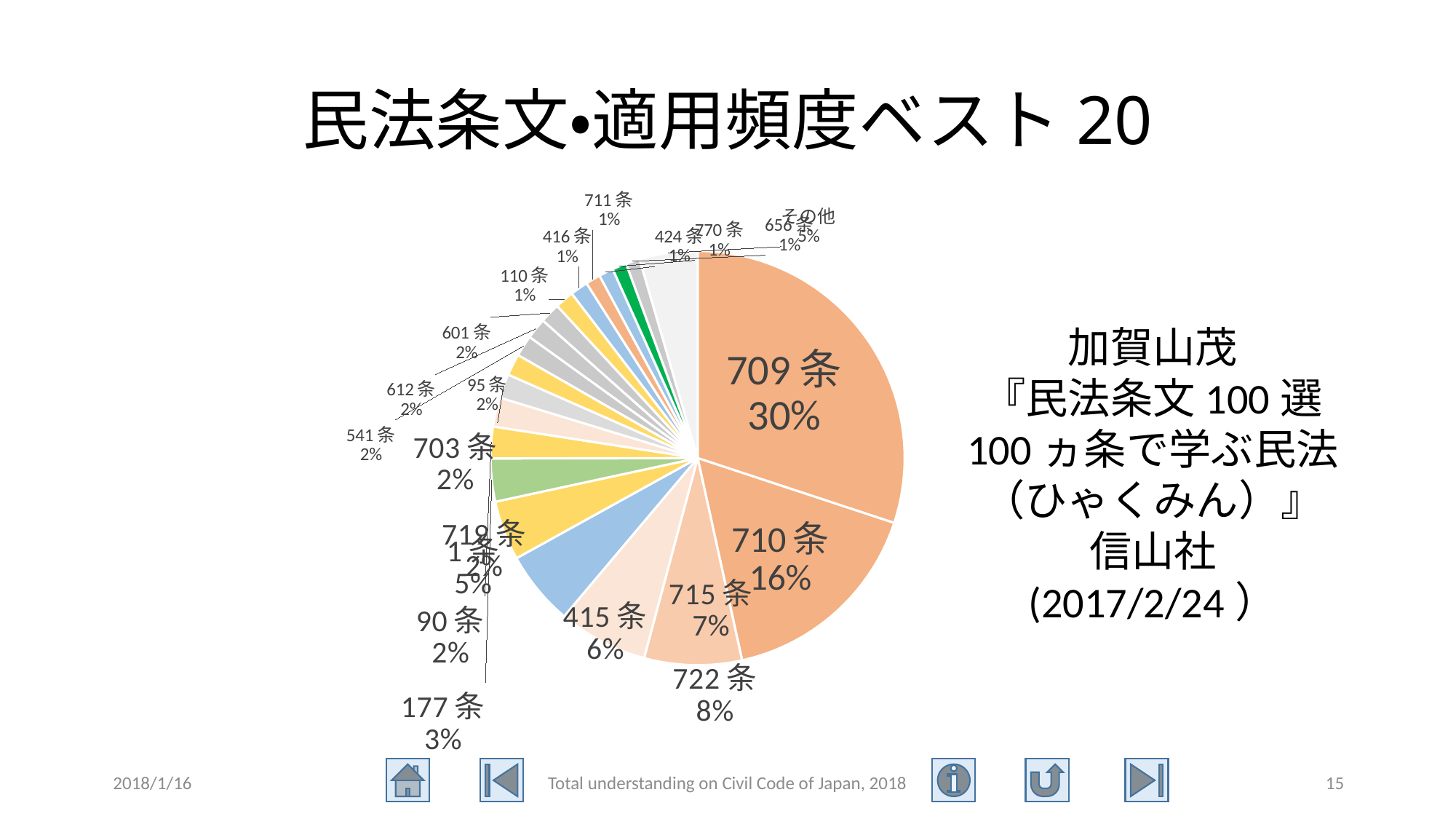
What percentage is shown for 177 条? 3% What percentage is shown for 415 条? 6% What percentage is shown for 715 条? 7% What percentage is shown for 710 条? 16% Which has the larger share, 722 条 or 715 条? 722 条 What percentage is shown for その他 (other)? 5% Which article (条) has the largest slice of the pie? 709 条 What is the difference in percentage points between 709 条 and 710 条? 14 What is the title of the chart on the slide? 民法条文•適用頻度ベスト 20 What share of the pie does 709 条 account for? 30% What percentage is shown for 722 条? 8% What kind of chart is shown on the slide? pie chart